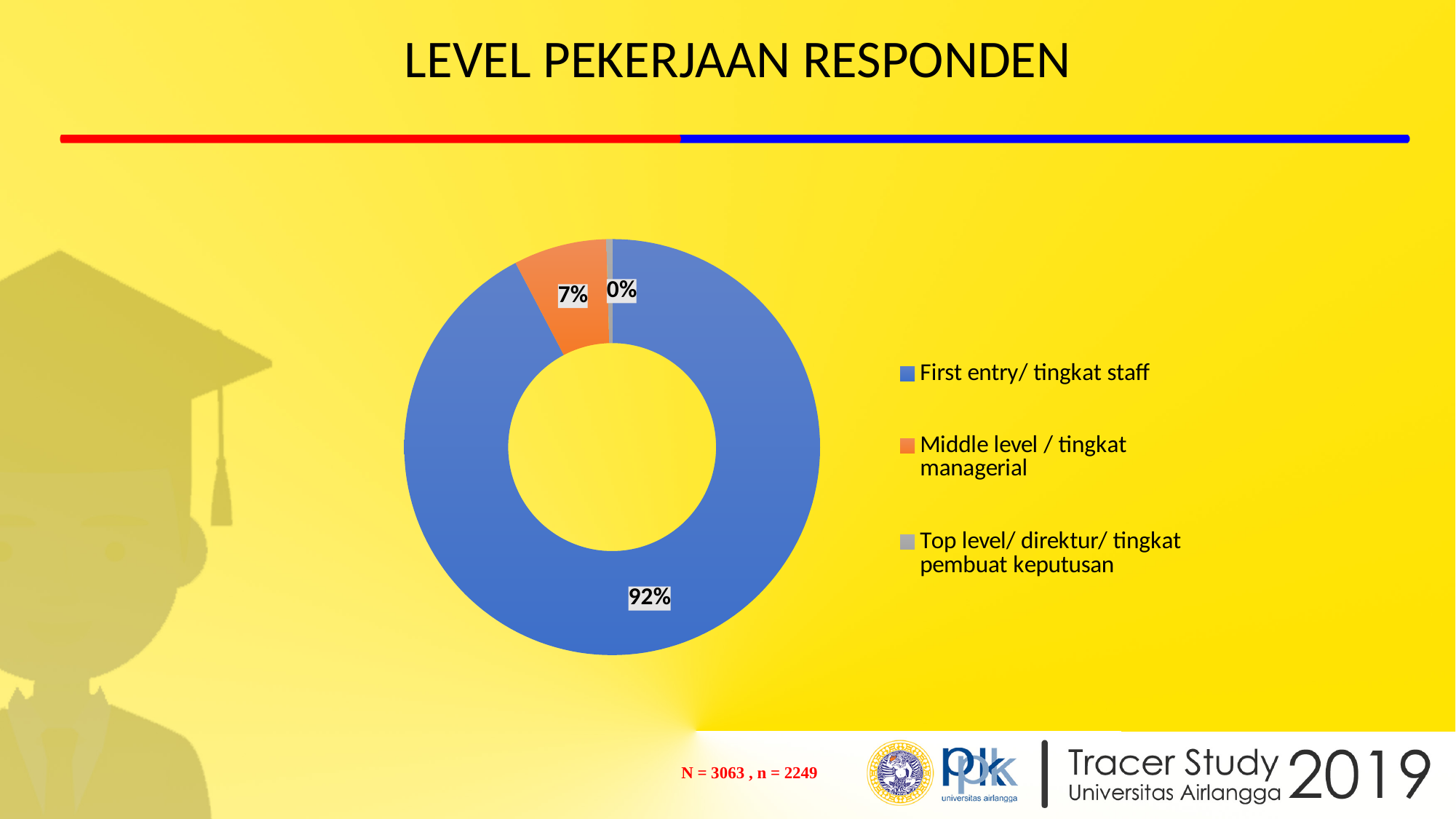
What colour represents the Middle level / tingkat managerial category? Orange Which job level has the largest share of respondents? First entry/ tingkat staff What is the share of the chart taken by the First entry/ tingkat staff slice? 92% What is the difference in percentage points between First entry/ tingkat staff and Middle level / tingkat managerial? 85 What is the title of the slide? LEVEL PEKERJAAN RESPONDEN What percentage is shown for Top level/ direktur/ tingkat pembuat keputusan? 0% How many job level categories are shown in the chart? 3 What percentage of respondents are at the Middle level / tingkat managerial level? 7% What type of chart is used on this slide? Doughnut chart Which has a larger share: Middle level / tingkat managerial or Top level/ direktur/ tingkat pembuat keputusan? Middle level / tingkat managerial What percentage of respondents are at the First entry/ tingkat staff level? 92% Which job level has the smallest share of respondents? Top level/ direktur/ tingkat pembuat keputusan